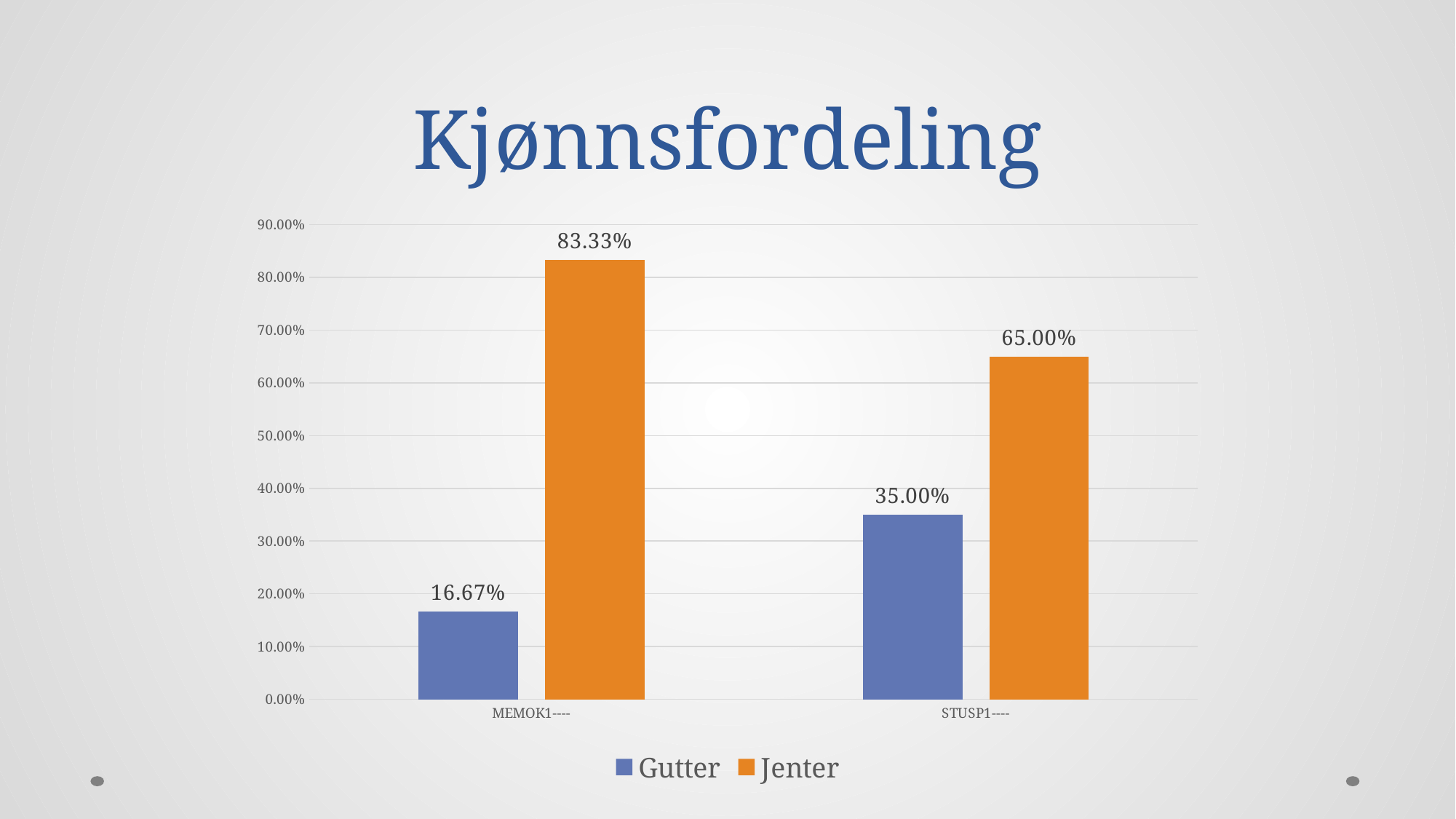
What is the value for Gutter in the MEMOK1---- category? 16.67% Which category has the highest Jenter value? MEMOK1---- How many categories are shown on the x axis? 2 What is the difference between the Jenter and Gutter values in the STUSP1---- category? 30.00% How many series does the legend list? 2 What is the value for Jenter in the MEMOK1---- category? 83.33% Is the Gutter value for STUSP1---- greater or less than 40.00%? less What kind of chart is shown on the slide? bar chart Which is larger in the MEMOK1---- category, Gutter or Jenter? Jenter What is the value for Jenter in the STUSP1---- category? 65.00% Which category has the lowest Gutter value? MEMOK1---- What is the value for Gutter in the STUSP1---- category? 35.00%